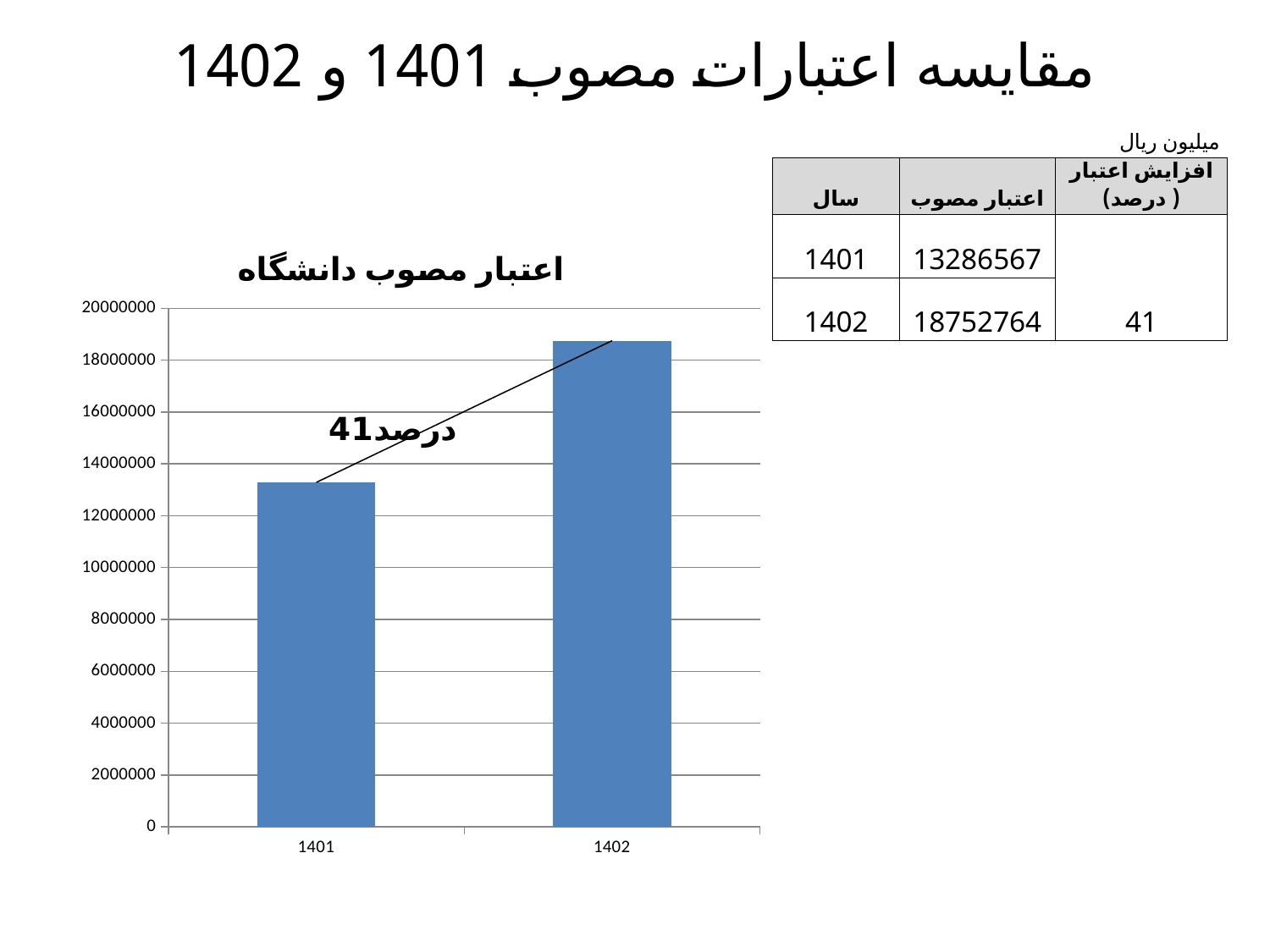
What kind of chart is shown on the slide? bar chart Which year has the lower bar in the chart? 1401 What percentage increase is annotated between the 1401 and 1402 bars? 41 درصد How many bars (categories) does the chart show? 2 Do the values rise or fall from 1401 to 1402? rise Which year has the higher bar in the chart? 1402 Is the bar for 1401 greater or less than 14000000? less According to the slide, what is the approved credit (اعتبار مصوب) for 1401? 13286567 According to the slide, what is the approved credit (اعتبار مصوب) for 1402? 18752764 Is the bar for 1402 greater or less than 18000000? greater Is the bar for 1401 greater or less than 12000000? greater